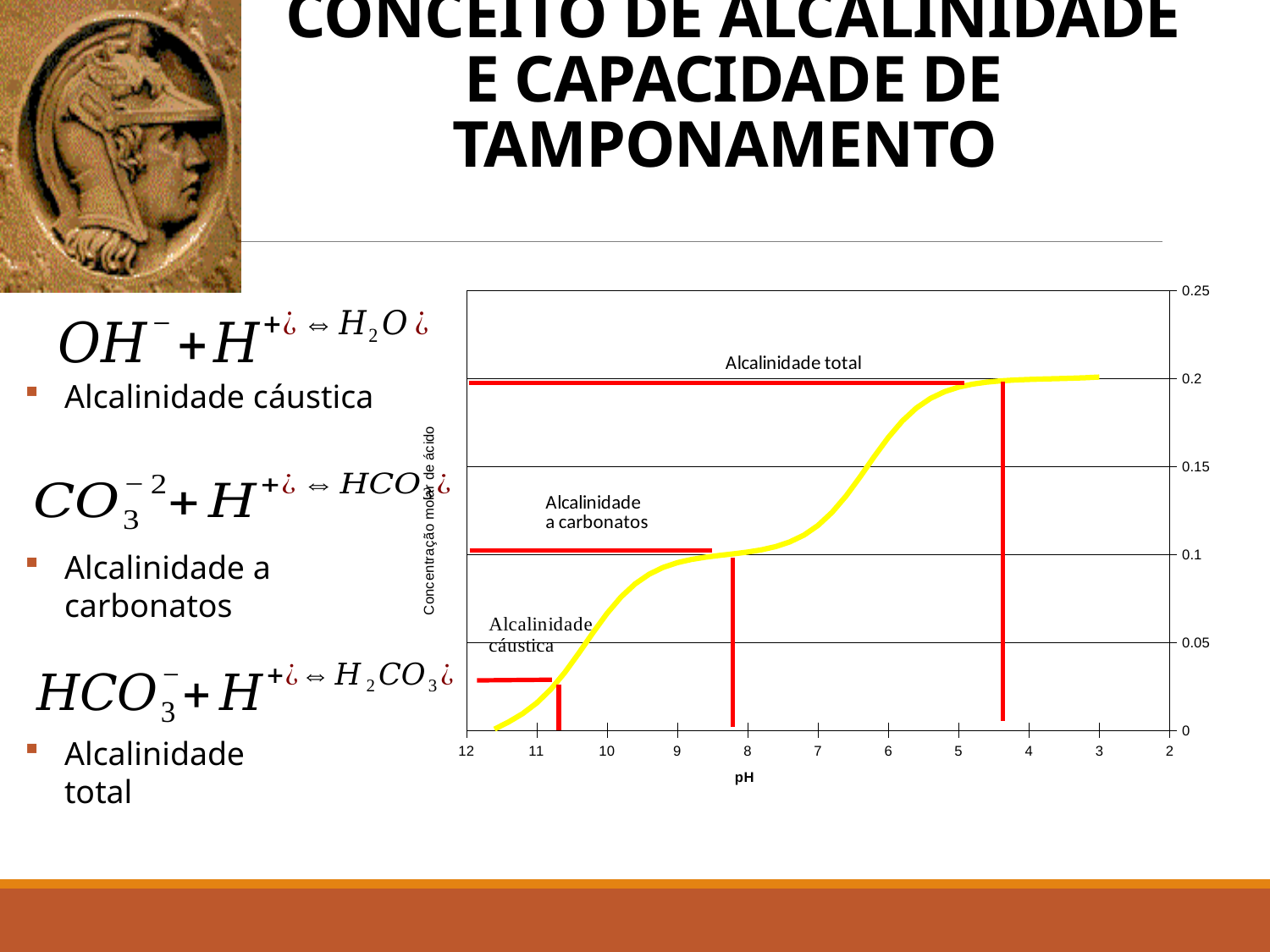
Is the value of the yellow curve at pH 11 greater or less than 0.05? less Is the value of the yellow curve at pH 3 greater or less than 0.15? greater Moving from left to right along the x axis (from pH 12 toward pH 2), does the yellow curve rise or fall? rise Is the value of the yellow curve at pH 10 greater or less than 0.05? greater Which has a larger value on the yellow curve, pH 11 or pH 7? pH 7 What is the label of the y axis of the chart? Concentração molar de ácido What kind of chart is shown on the slide? line chart How many red vertical marker lines are drawn on the chart? 3 What is the label of the x axis of the chart? pH Which has a larger value on the yellow curve, pH 5 or pH 9? pH 5